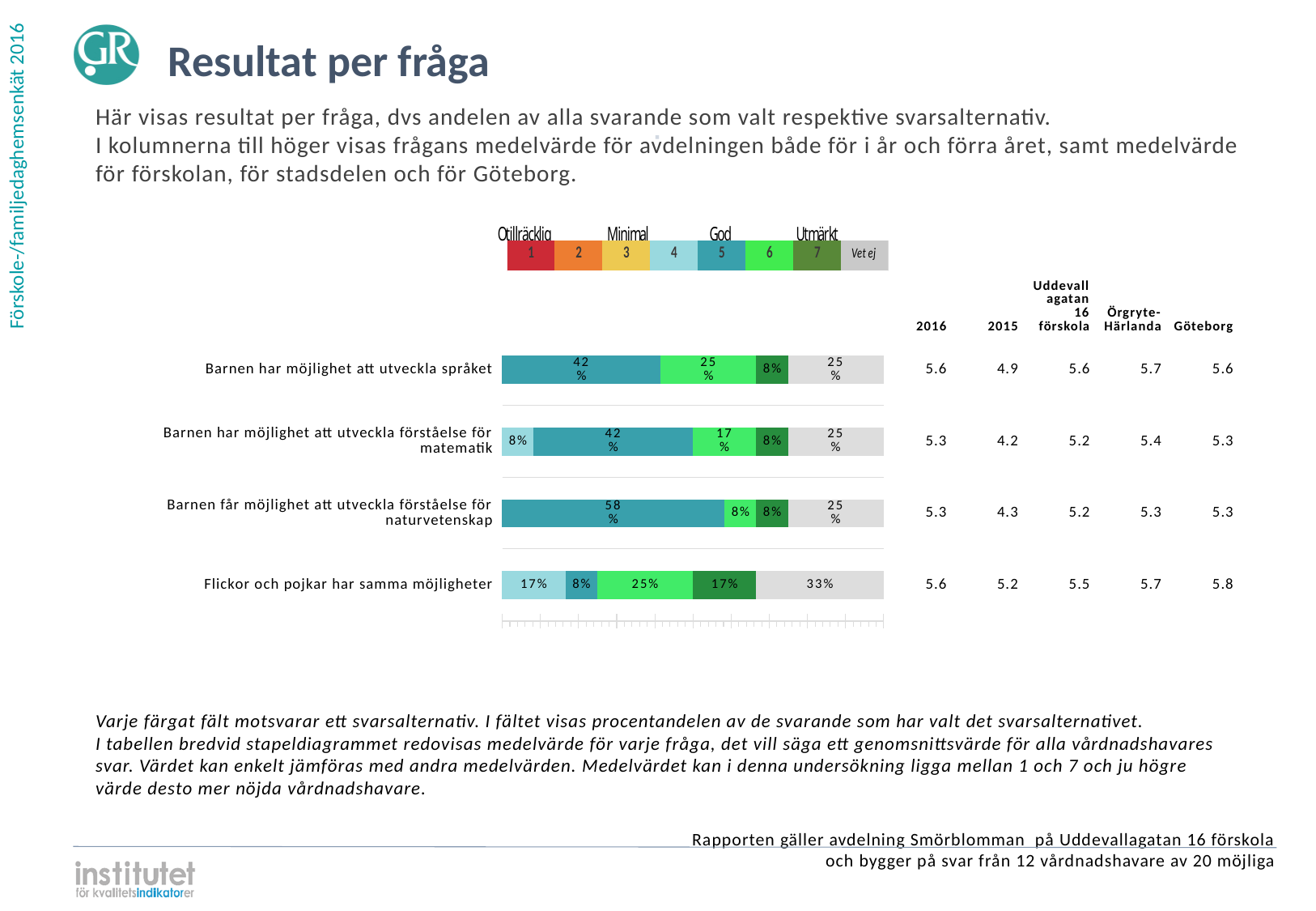
What percentage of respondents chose answer 5 for 'Barnen får möjlighet att utveckla förståelse för naturvetenskap'? 58% What kind of chart is shown on the slide? Stacked bar chart Which question has the largest 'Vet ej' share? Flickor och pojkar har samma möjligheter How many questions (bars) are plotted in the chart? 4 How many answer alternatives does the legend above the chart list? 8 What is the difference in percentage points between the answer-5 share for 'Barnen får möjlighet att utveckla förståelse för naturvetenskap' (58%) and for 'Barnen har möjlighet att utveckla språket' (42%)? 16 percentage points Which is larger: the answer-7 share for 'Flickor och pojkar har samma möjligheter' or for 'Barnen har möjlighet att utveckla språket'? Flickor och pojkar har samma möjligheter What percentage of respondents chose answer 4 for 'Barnen har möjlighet att utveckla förståelse för matematik'? 8% What is the 2016 mean value shown for 'Barnen har möjlighet att utveckla förståelse för matematik'? 5.3 What percentage of respondents answered 'Vet ej' for 'Flickor och pojkar har samma möjligheter'? 33% What percentage of respondents chose answer 6 for 'Barnen har möjlighet att utveckla språket'? 25% What is the Göteborg mean value shown for 'Flickor och pojkar har samma möjligheter'? 5.8